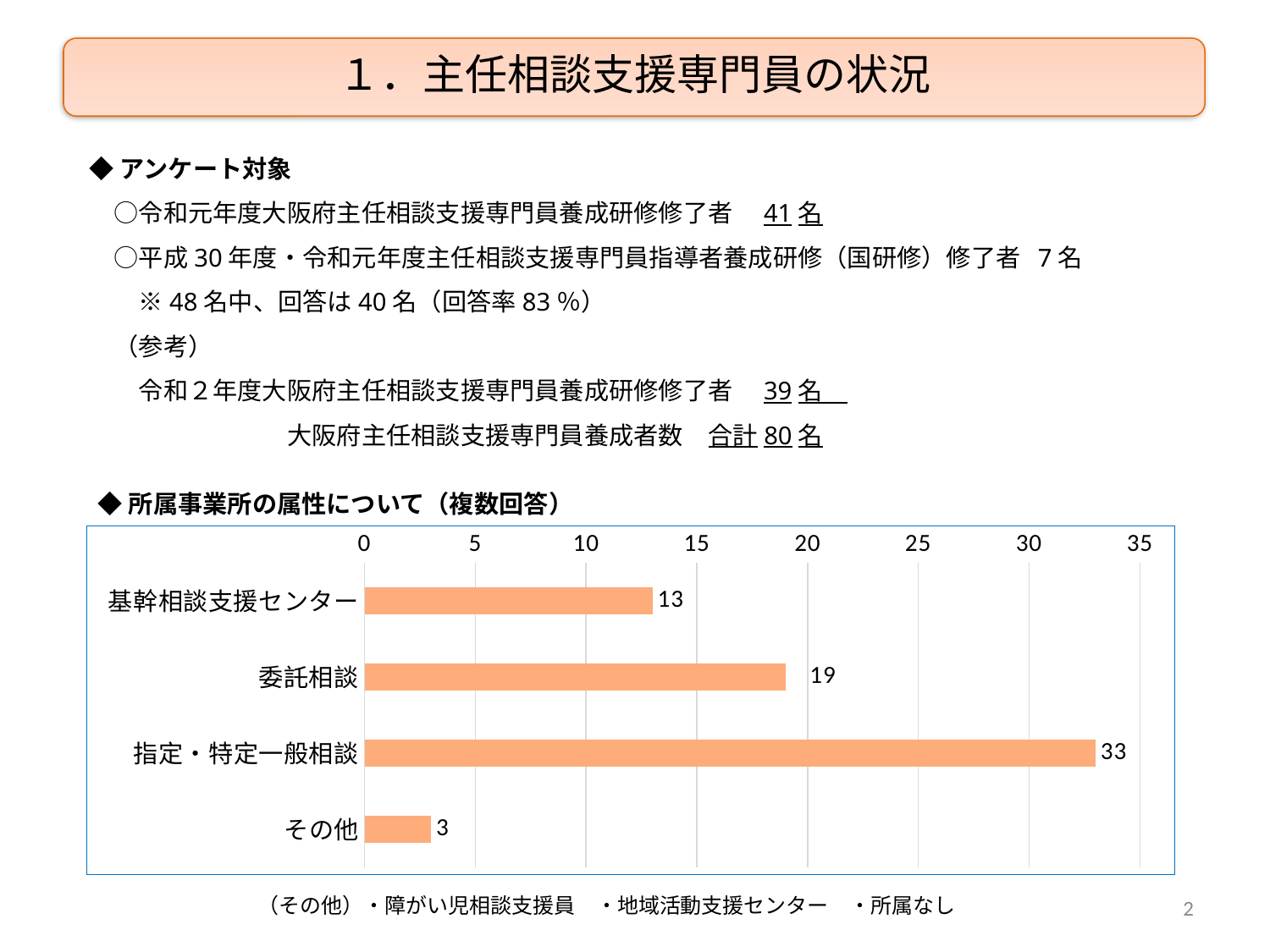
Is the value for 指定・特定一般相談 greater or less than 30? greater Which category has the lowest value? その他 What kind of chart is shown on the slide? bar chart How many categories are shown in the chart? 4 What is the value for 委託相談? 19 What is the value for 指定・特定一般相談? 33 What is the maximum value shown on the chart's axis? 35 What is the value for その他? 3 What is the value for 基幹相談支援センター? 13 Which is larger, the value for 委託相談 or the value for 基幹相談支援センター? 委託相談 Which category has the highest value? 指定・特定一般相談 What is the difference between the values for 指定・特定一般相談 and 委託相談? 14